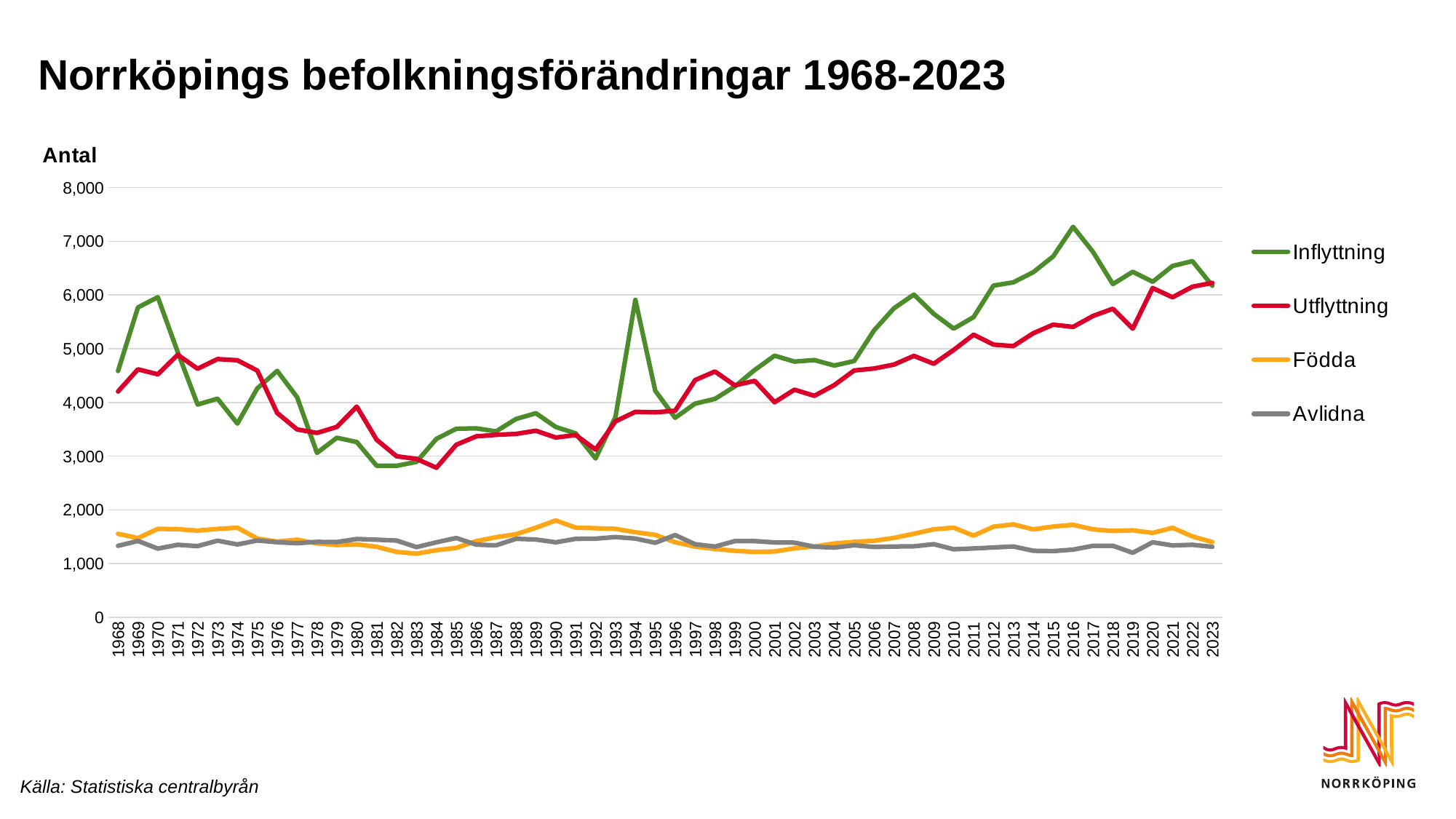
How many years are plotted along the x axis? 56 What kind of chart is shown on the slide? line chart Is the value for Inflyttning in 2016 greater or less than 7,000? greater Is the value for Födda in 1990 greater or less than 1,500? greater How many series does the legend list? 4 Is the value for Inflyttning in 1994 greater or less than 5,000? greater In which year does the Inflyttning line reach its highest value? 2016 In 1984, which is larger, Inflyttning or Utflyttning? Inflyttning In 2016, which is larger, Inflyttning or Utflyttning? Inflyttning What colour is the Födda line in the legend? orange Does the Utflyttning line generally rise or fall from 2000 to 2023? rise